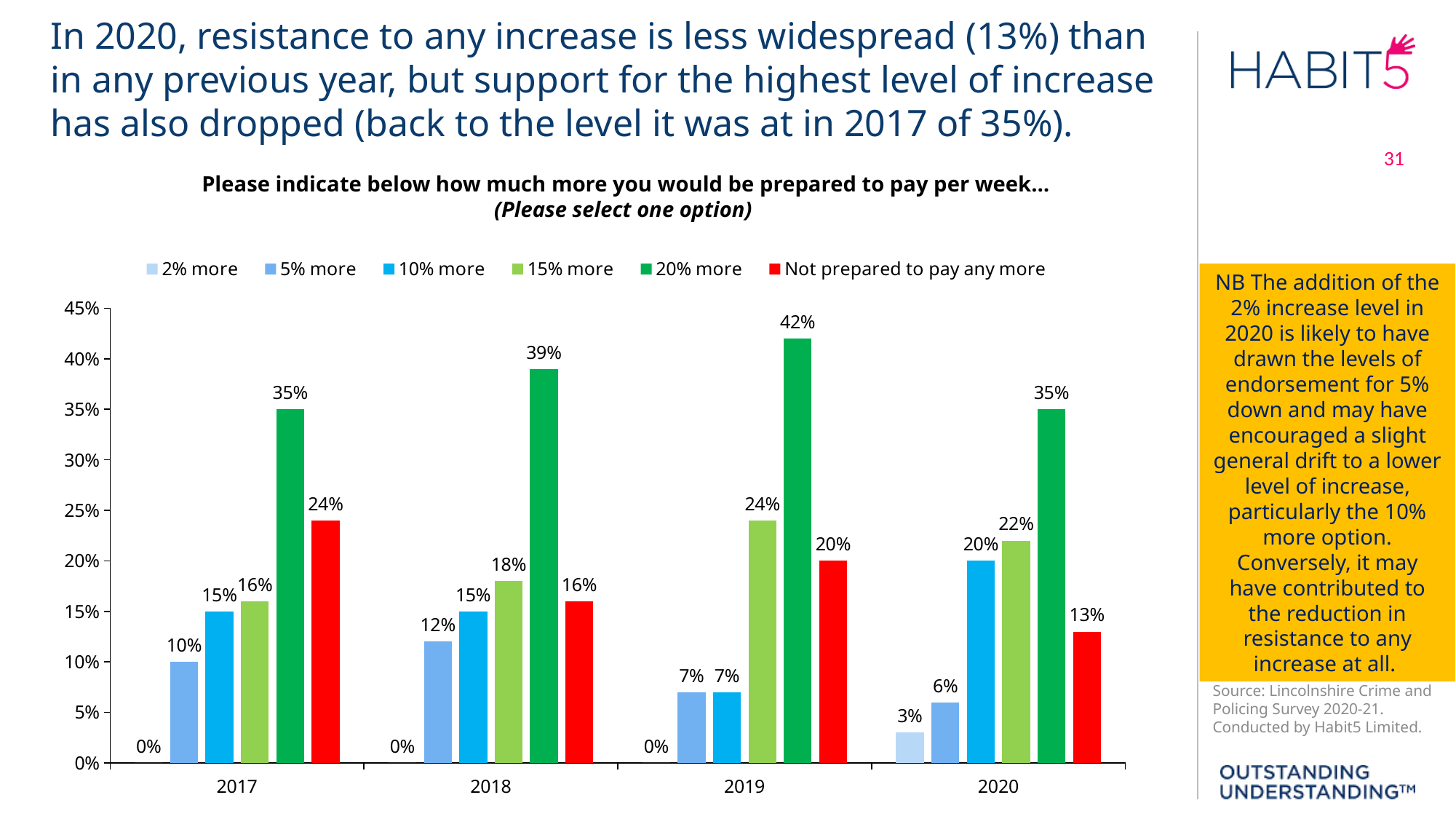
What kind of chart is shown on the slide? Bar chart What is the difference between the 'Not prepared to pay any more' values for 2017 and 2020? 11% What is the value for '20% more' in 2019? 42% How many series does the legend list? 6 In which year is the value for '20% more' highest? 2019 Which is larger: the '15% more' value in 2019 or the '15% more' value in 2020? 2019 How many years are shown on the x axis? 4 What is the value for '10% more' in 2020? 20% What is the value for 'Not prepared to pay any more' in 2020? 13% In which year is the value for 'Not prepared to pay any more' lowest? 2020 What is the value for '5% more' in 2018? 12% Which colour represents 'Not prepared to pay any more' in the legend? Red